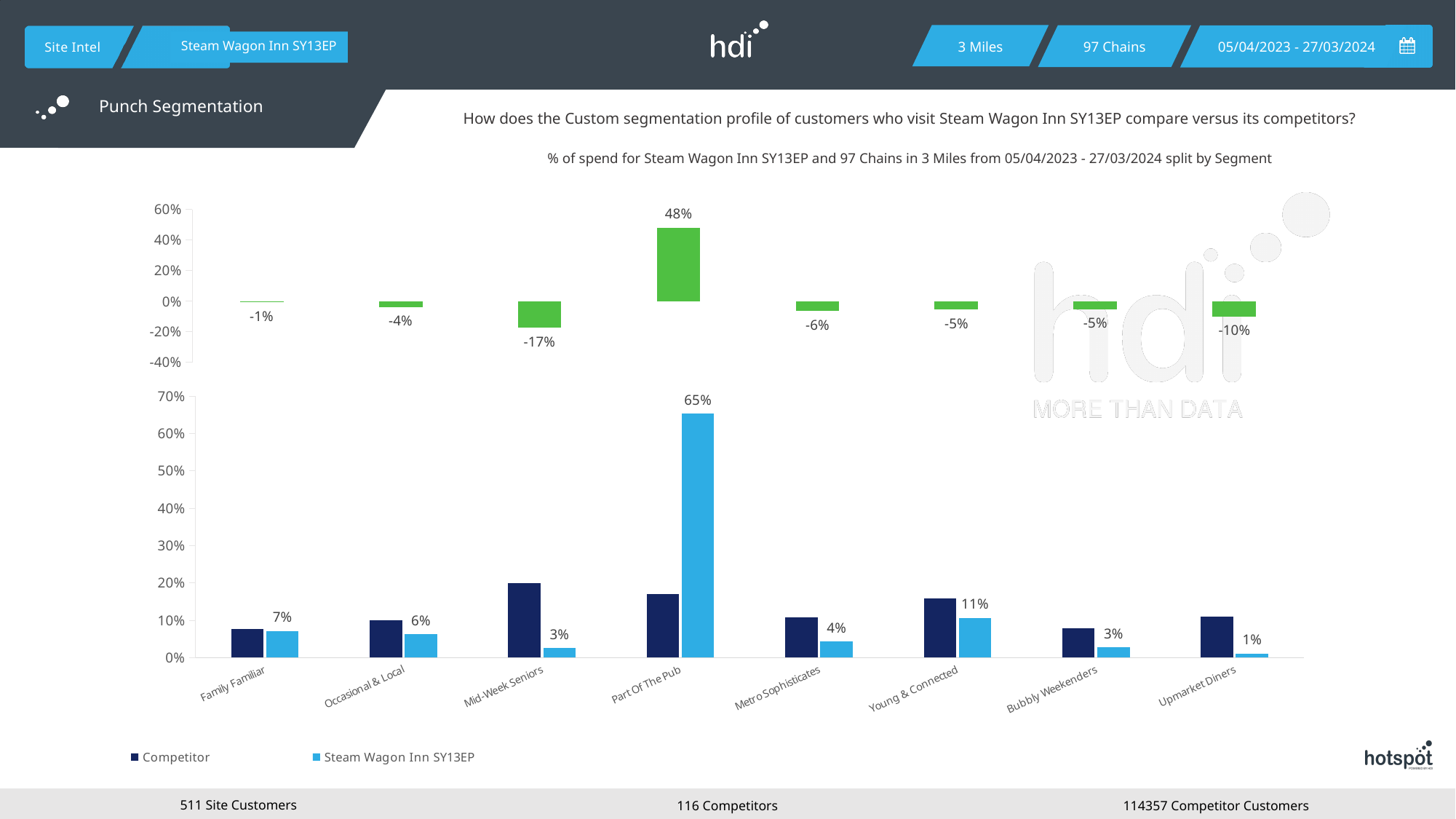
In the bottom chart, which is larger for Mid-Week Seniors: the Competitor value or the Steam Wagon Inn SY13EP value? Competitor In the bottom chart, what is the difference between the Steam Wagon Inn SY13EP values for Family Familiar and Occasional & Local? 1% In the top chart, what is the value shown for Upmarket Diners? -10% In the bottom chart, is the Competitor value for Part Of The Pub greater or less than 10%? greater In the bottom chart, what is the value for Steam Wagon Inn SY13EP in the Young & Connected segment? 11% How many series does the legend of the bottom chart list? 2 In the top chart, what is the value shown for Mid-Week Seniors? -17% In the top chart, which segment has the highest value? Part Of The Pub In the bottom chart, what is the value for Steam Wagon Inn SY13EP in the Part Of The Pub segment? 65% In the bottom chart, which segment has the lowest value for Steam Wagon Inn SY13EP? Upmarket Diners In the bottom chart, is the Competitor value for Family Familiar greater or less than 10%? less How many segments are shown on the x axis of the bottom chart? 8